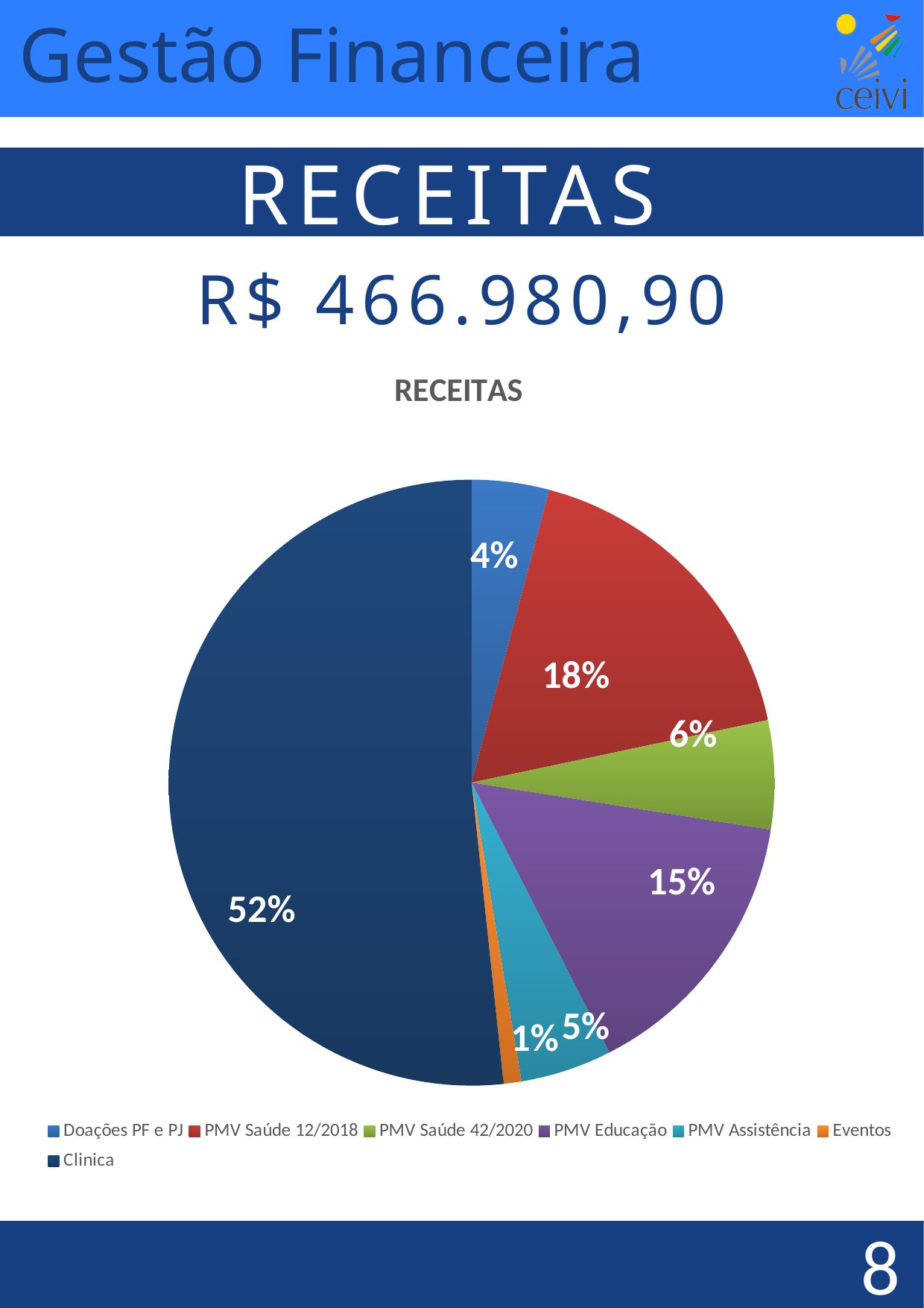
Which category has the largest slice of the pie? Clinica Which category has the smallest slice of the pie? Eventos What colour is the slice for Eventos? orange How many slices does the pie chart have? 7 What share of the pie does Clinica represent? 52% What share of the pie does PMV Saúde 12/2018 represent? 18% What kind of chart is shown on the slide? pie chart What share of the pie does PMV Educação represent? 15% What is the title of the chart? RECEITAS Which is larger, the slice for PMV Educação or the slice for PMV Assistência? PMV Educação What is the difference in percentage points between PMV Saúde 12/2018 and PMV Saúde 42/2020? 12